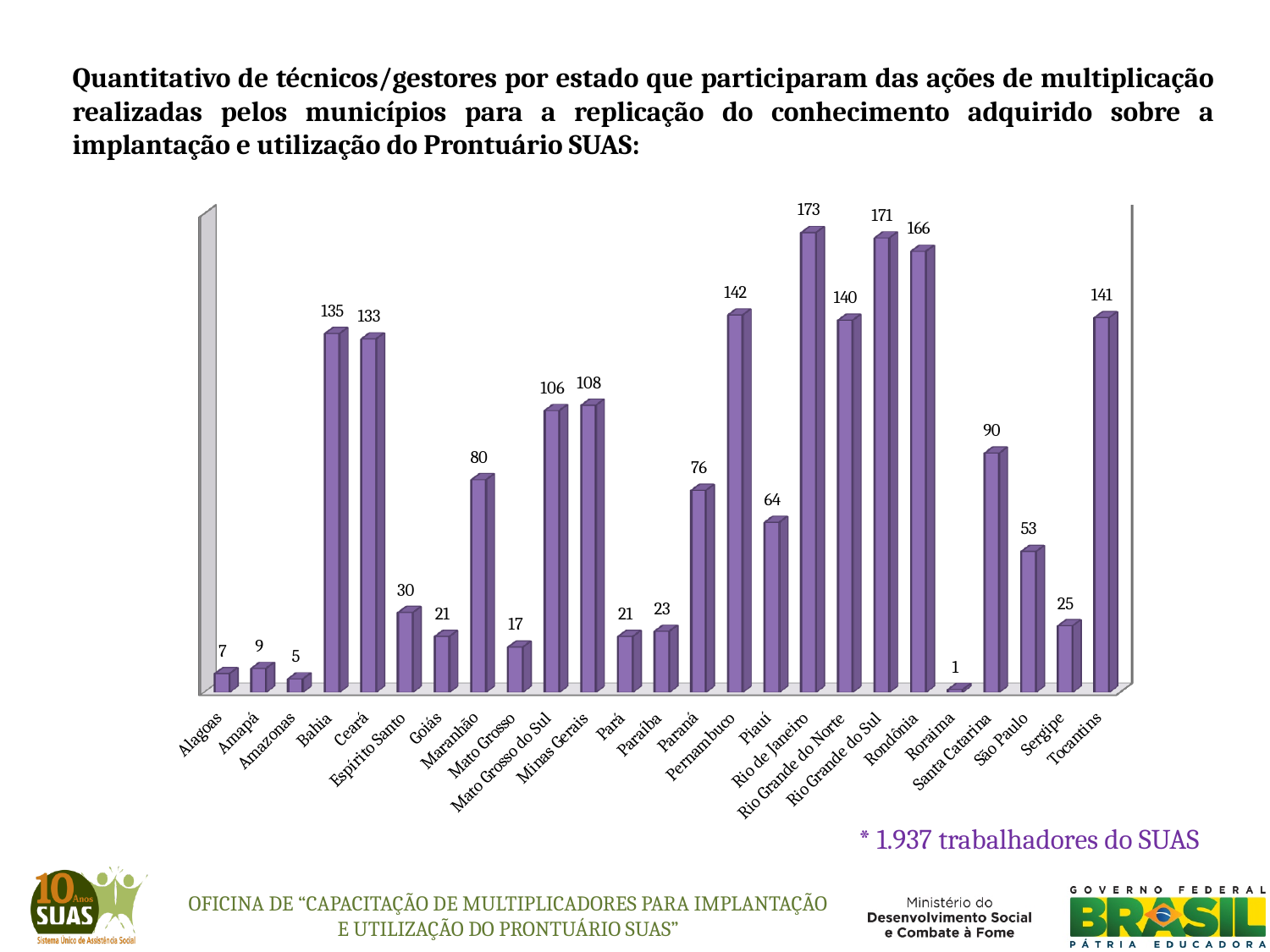
What is the difference between the values for Pernambuco and Piauí? 78 What is the value for Rio Grande do Norte? 140 Which state has the lowest value? Roraima What total number of SUAS workers is stated in the note below the chart? 1.937 Which state has the highest value? Rio de Janeiro What is the value for Mato Grosso? 17 What kind of chart is shown on the slide? Bar chart How many states are shown on the x axis? 25 Which is larger, the value for Minas Gerais or the value for Mato Grosso do Sul? Minas Gerais What is the difference between the values for Bahia and Ceará? 2 What is the value for Santa Catarina? 90 What is the value for Maranhão? 80